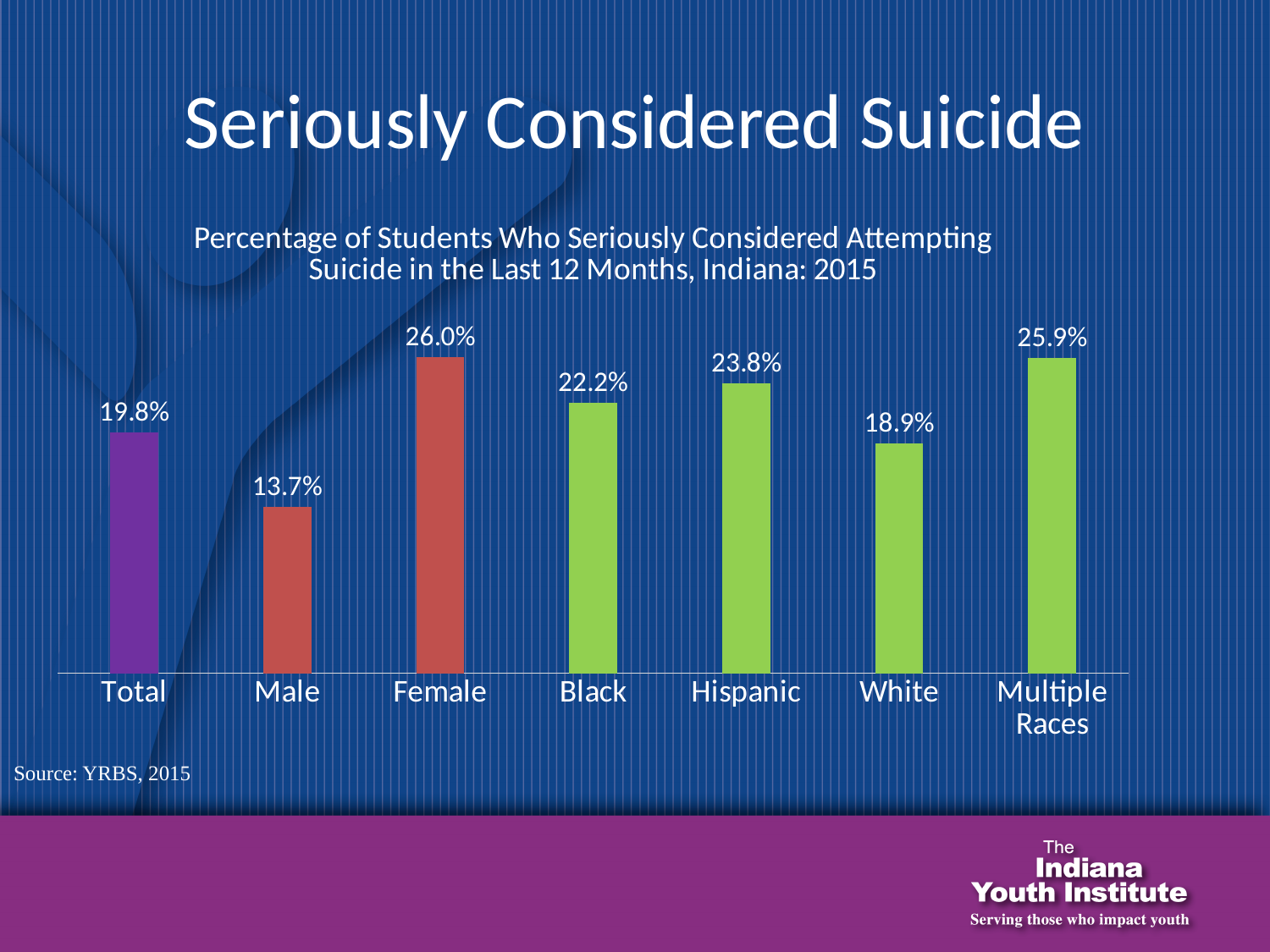
How many categories are shown on the chart? 7 What is the value for Multiple Races? 25.9% What is the value for Hispanic? 23.8% What is the value for Male? 13.7% What is the value for Total? 19.8% What is the difference between the Female and Male values? 12.3% What kind of chart is shown on the slide? Bar chart Which is larger, the value for Hispanic or the value for White? Hispanic Which category has the highest value? Female Which category has the lowest value? Male What is the title of the chart? Percentage of Students Who Seriously Considered Attempting Suicide in the Last 12 Months, Indiana: 2015 What is the difference between the Black and White values? 3.3%